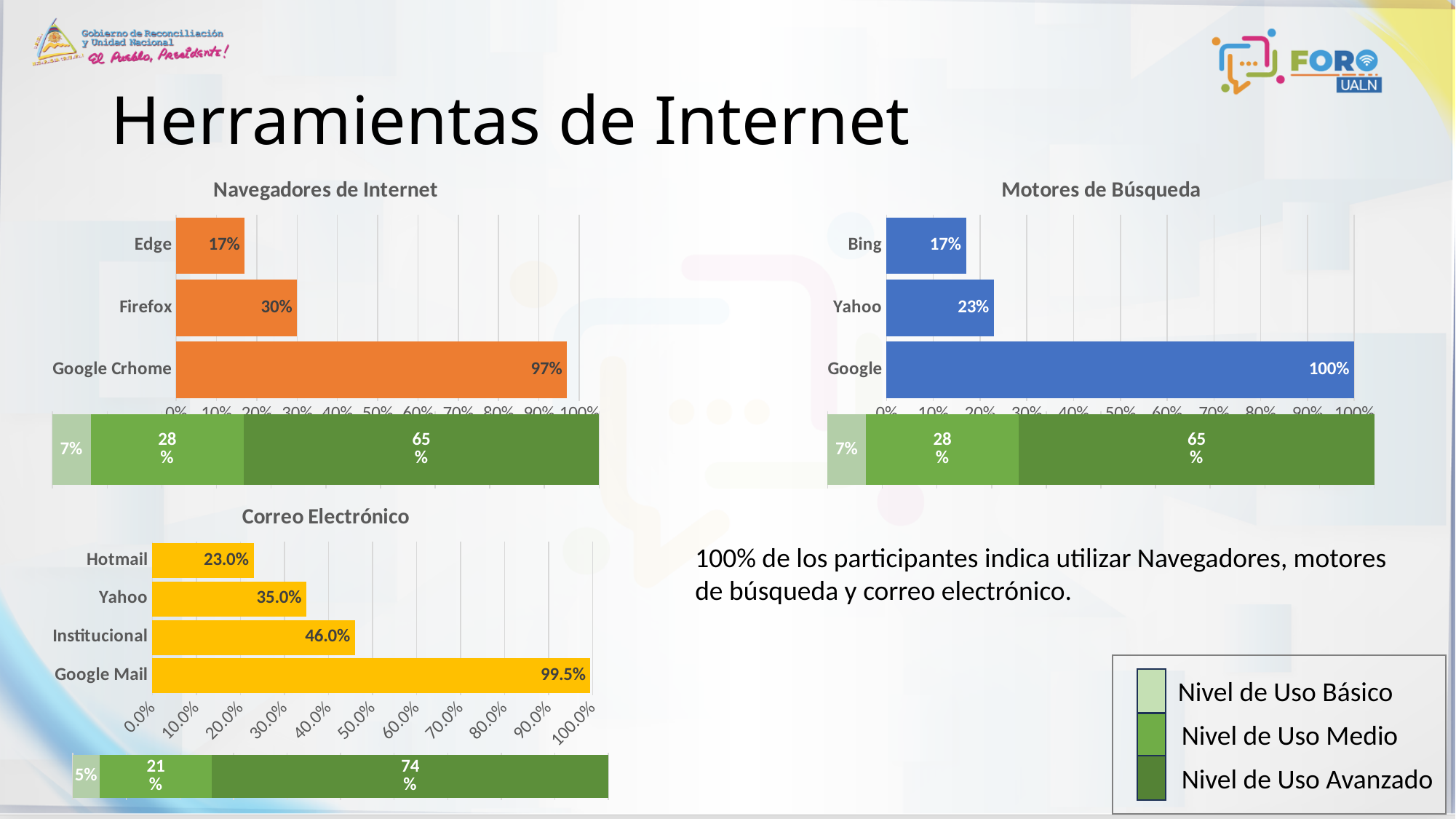
In the 'Navegadores de Internet' chart, which browser has the highest value? Google Crhome In the 'Navegadores de Internet' chart, what is the difference between Google Crhome and Edge? 80% In the 'Motores de Búsqueda' chart, what is the value for Yahoo? 23% In the 'Motores de Búsqueda' chart, which search engine has the lowest value? Bing In the 'Correo Electrónico' chart, what is the difference between Google Mail and Institucional? 53.5% In the 'Motores de Búsqueda' chart, how many search engines are shown? 3 In the 'Correo Electrónico' chart, how many email services are listed? 4 In the 'Correo Electrónico' chart, which is larger, Hotmail or Yahoo? Yahoo In the stacked bar below the 'Correo Electrónico' chart, what is the value for Nivel de Uso Avanzado? 74% In the 'Correo Electrónico' chart, what is the value for Institucional? 46.0% What type of chart is 'Navegadores de Internet'? Bar chart In the 'Navegadores de Internet' chart, what is the value for Firefox? 30%